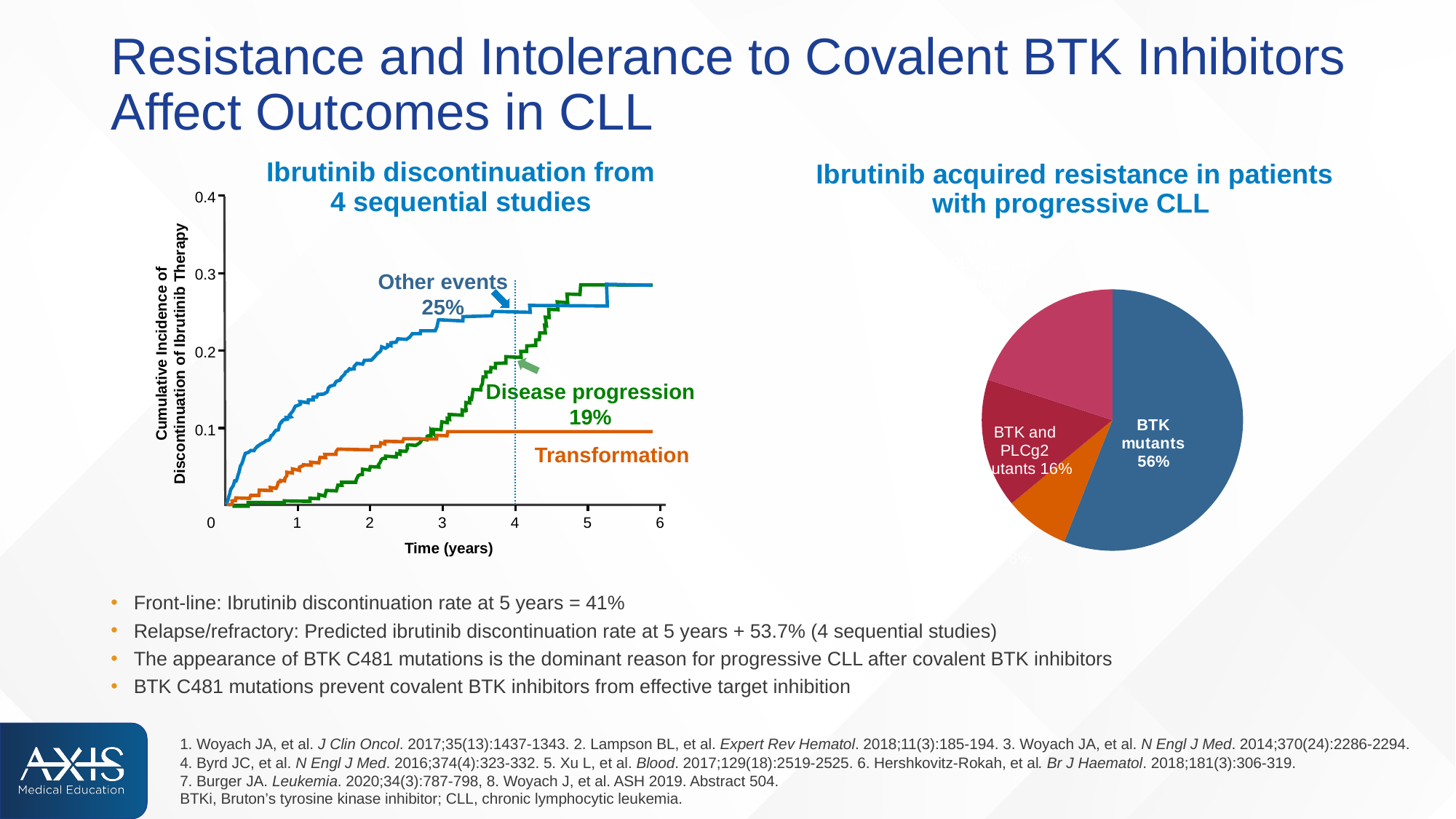
In the 'Ibrutinib acquired resistance in patients with progressive CLL' pie chart, which slice is the largest? BTK mutants In the 'Ibrutinib discontinuation from 4 sequential studies' chart, is the Transformation curve at 6 years greater or less than 0.2? less In the 'Ibrutinib discontinuation from 4 sequential studies' chart, what is the difference between the labelled Other events value and the Disease progression value at 4 years? 6 percentage points What kind of chart is the 'Ibrutinib discontinuation from 4 sequential studies' chart? Line chart In the 'Ibrutinib acquired resistance in patients with progressive CLL' pie chart, what share is labelled for BTK mutants? 56% In the 'Ibrutinib discontinuation from 4 sequential studies' chart, which is larger at 4 years: Other events or Disease progression? Other events How many series (curves) are plotted in the 'Ibrutinib discontinuation from 4 sequential studies' chart? 3 In the 'Ibrutinib discontinuation from 4 sequential studies' chart, does the Other events curve rise or fall as time increases? Rise In the 'Ibrutinib discontinuation from 4 sequential studies' chart, what value is labelled for Other events at 4 years? 25% In the 'Ibrutinib acquired resistance in patients with progressive CLL' pie chart, what share is labelled for BTK and PLCg2 mutants? 16% In the 'Ibrutinib discontinuation from 4 sequential studies' chart, what value is labelled for Disease progression at 4 years? 19% What kind of chart is the 'Ibrutinib acquired resistance in patients with progressive CLL' chart? Pie chart